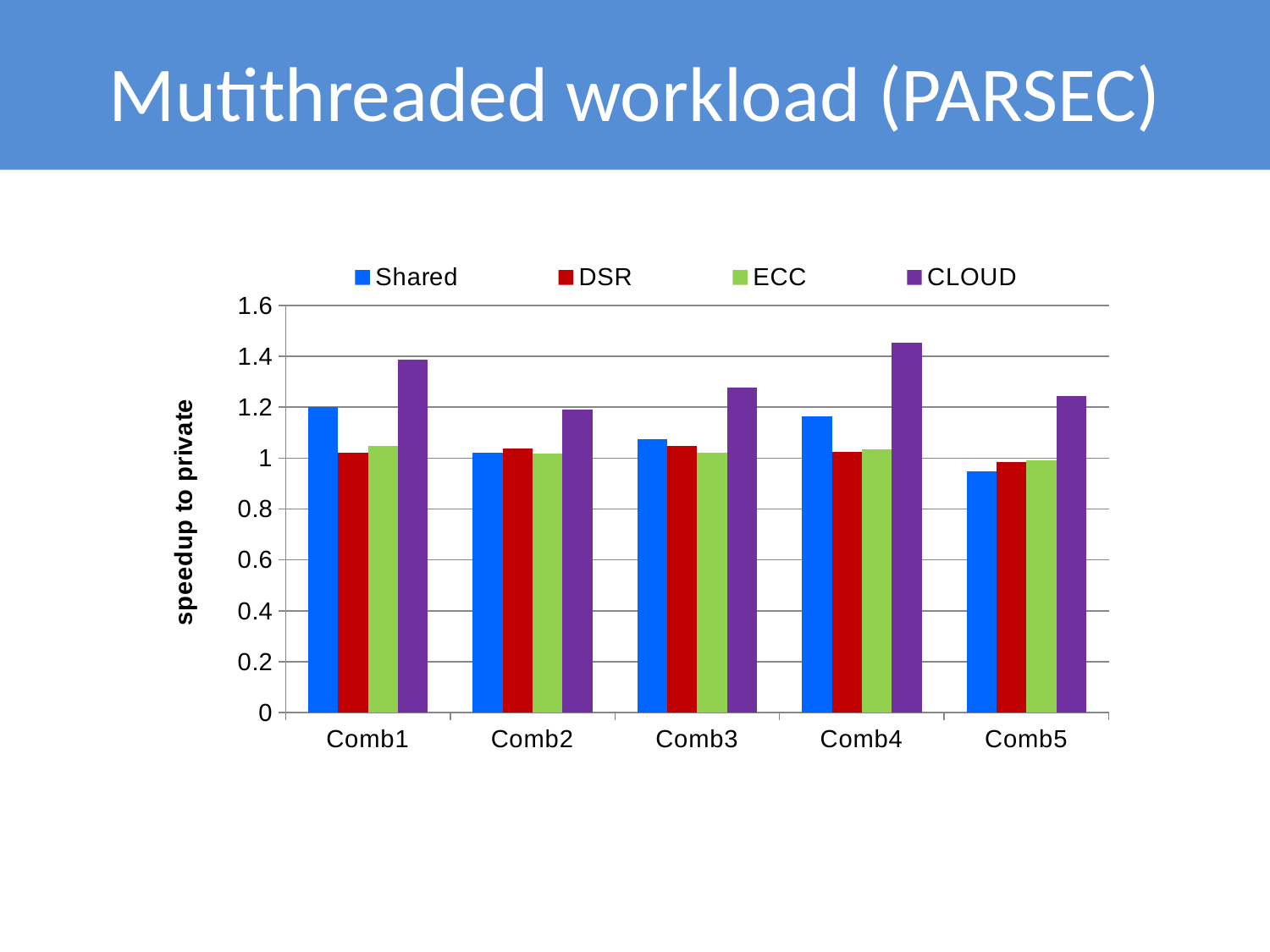
How many categories are shown on the x axis? 5 Which category has the highest CLOUD value? Comb4 For Comb1, which is larger: the Shared value or the CLOUD value? CLOUD How many series does the legend list? 4 Is the Shared value for Comb5 greater or less than 1? less Which category has the lowest Shared value? Comb5 Is the CLOUD value for Comb4 greater or less than 1.4? greater For Comb4, which is larger: the Shared value or the DSR value? Shared What colour represents the CLOUD series? purple Is the CLOUD value for Comb1 greater or less than 1.2? greater What is the label of the y axis? speedup to private What kind of chart is shown on the slide? bar chart